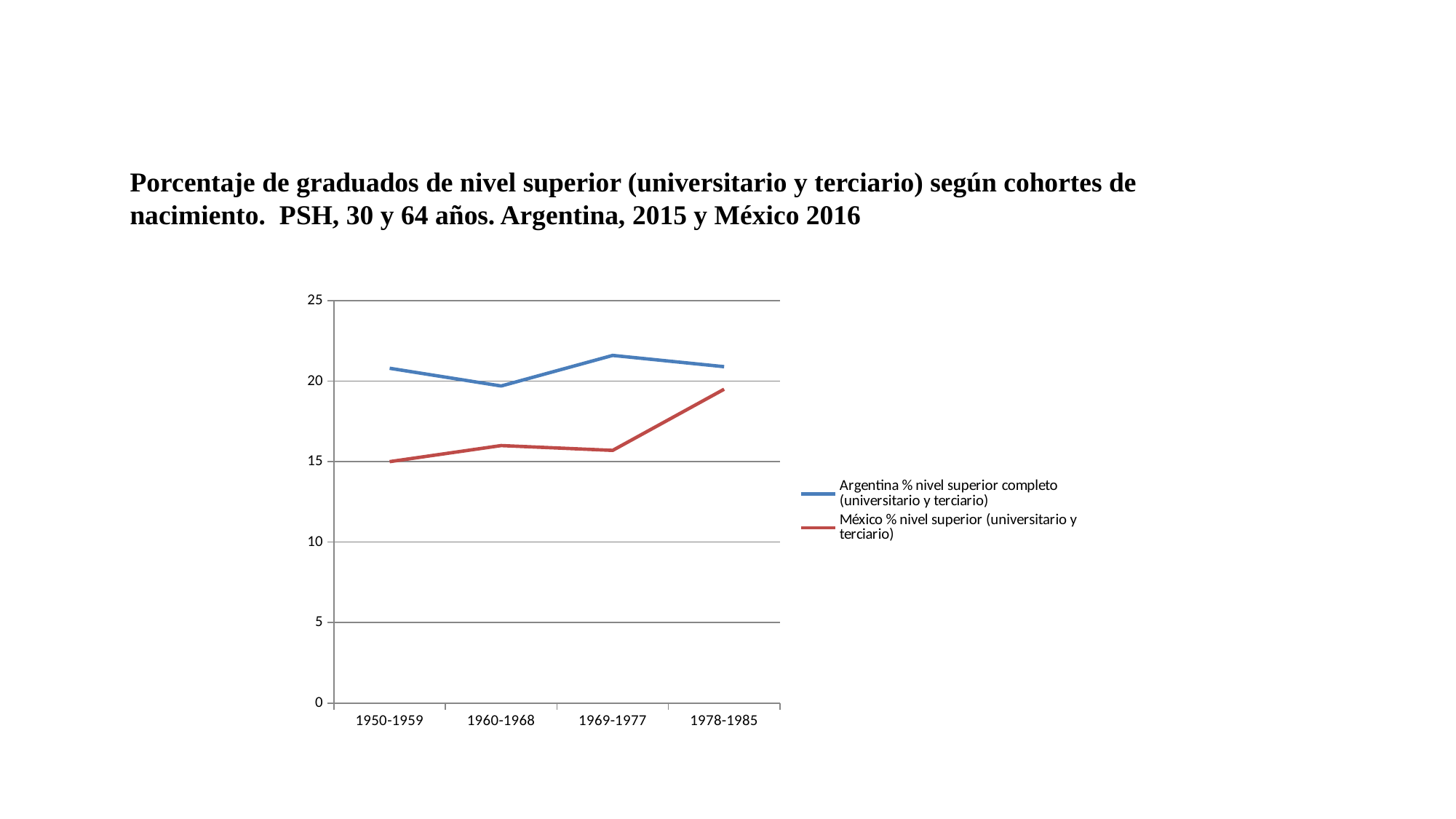
How many birth cohorts are shown on the x axis? 4 Which series is drawn in red? México % nivel superior (universitario y terciario) For which cohort is the México series highest? 1978-1985 What kind of chart is shown on the slide? line chart Is the value for México in the 1978-1985 cohort greater or less than 20? less Is the value for Argentina in the 1950-1959 cohort greater or less than 20? greater For which cohort is the Argentina series lowest? 1960-1968 Is the value for México in the 1960-1968 cohort greater or less than 15? greater In the 1978-1985 cohort, which series has the larger value, Argentina or México? Argentina How many series does the legend list? 2 For which cohort is the Argentina series highest? 1969-1977 Does the México series rise or fall from the 1969-1977 cohort to the 1978-1985 cohort? rise